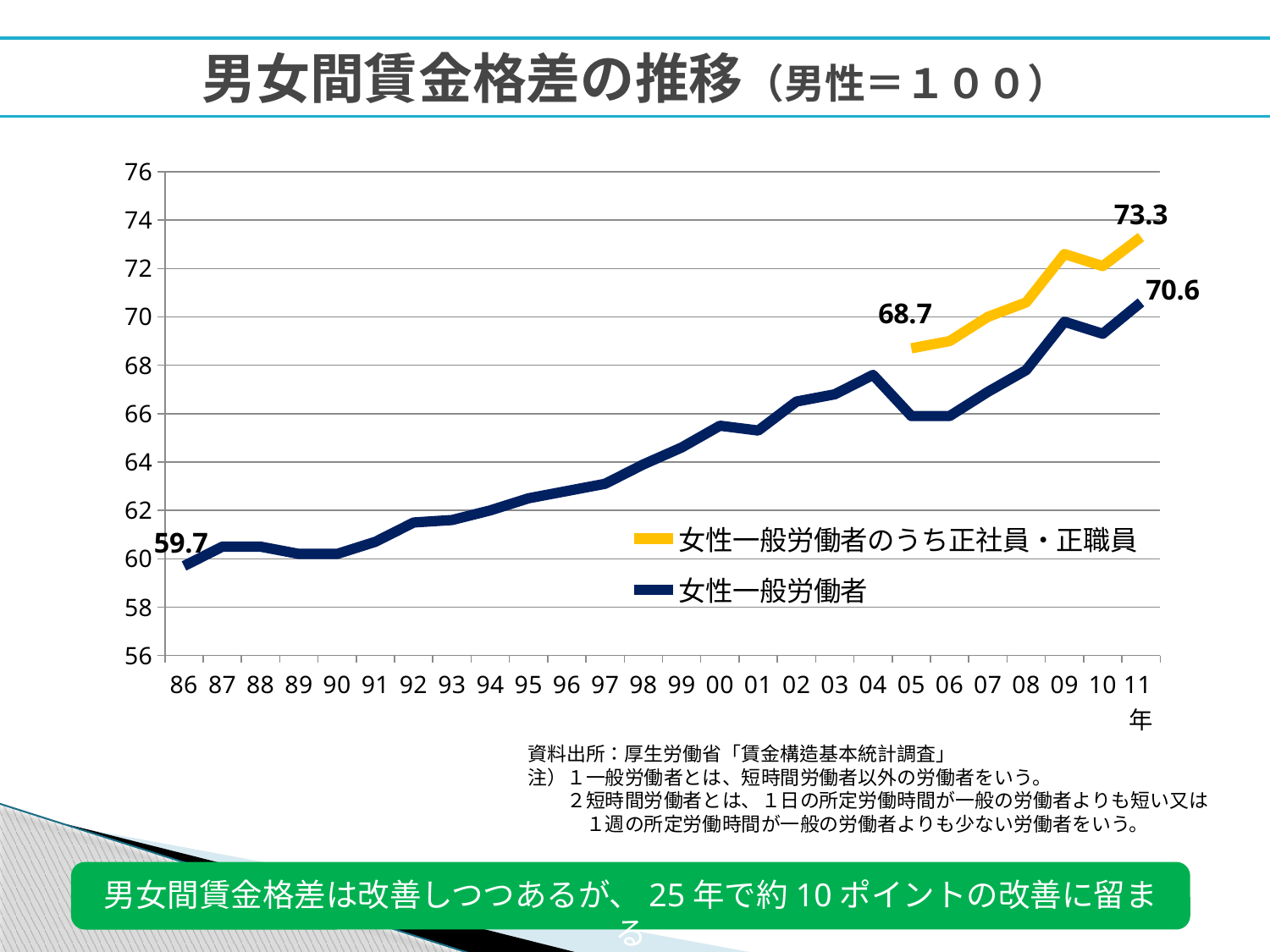
What is the value for 女性一般労働者のうち正社員・正職員 in 11? 73.3 What is the difference between 女性一般労働者のうち正社員・正職員 and 女性一般労働者 in 11? 2.7 What is the value for 女性一般労働者 in 11? 70.6 By how much did the value for 女性一般労働者 change from 86 to 11? 10.9 In 11, which series has the higher value: 女性一般労働者のうち正社員・正職員 or 女性一般労働者? 女性一般労働者のうち正社員・正職員 Which colour is used for the 女性一般労働者のうち正社員・正職員 line? yellow Does the value for 女性一般労働者 generally rise or fall from 86 to 11? rise How many series does the legend list? 2 Is the value for 女性一般労働者 in 00 greater or less than 64? greater What is the value for 女性一般労働者のうち正社員・正職員 in 05? 68.7 What is the value for 女性一般労働者 in 86? 59.7 What kind of chart is shown on the slide? line chart